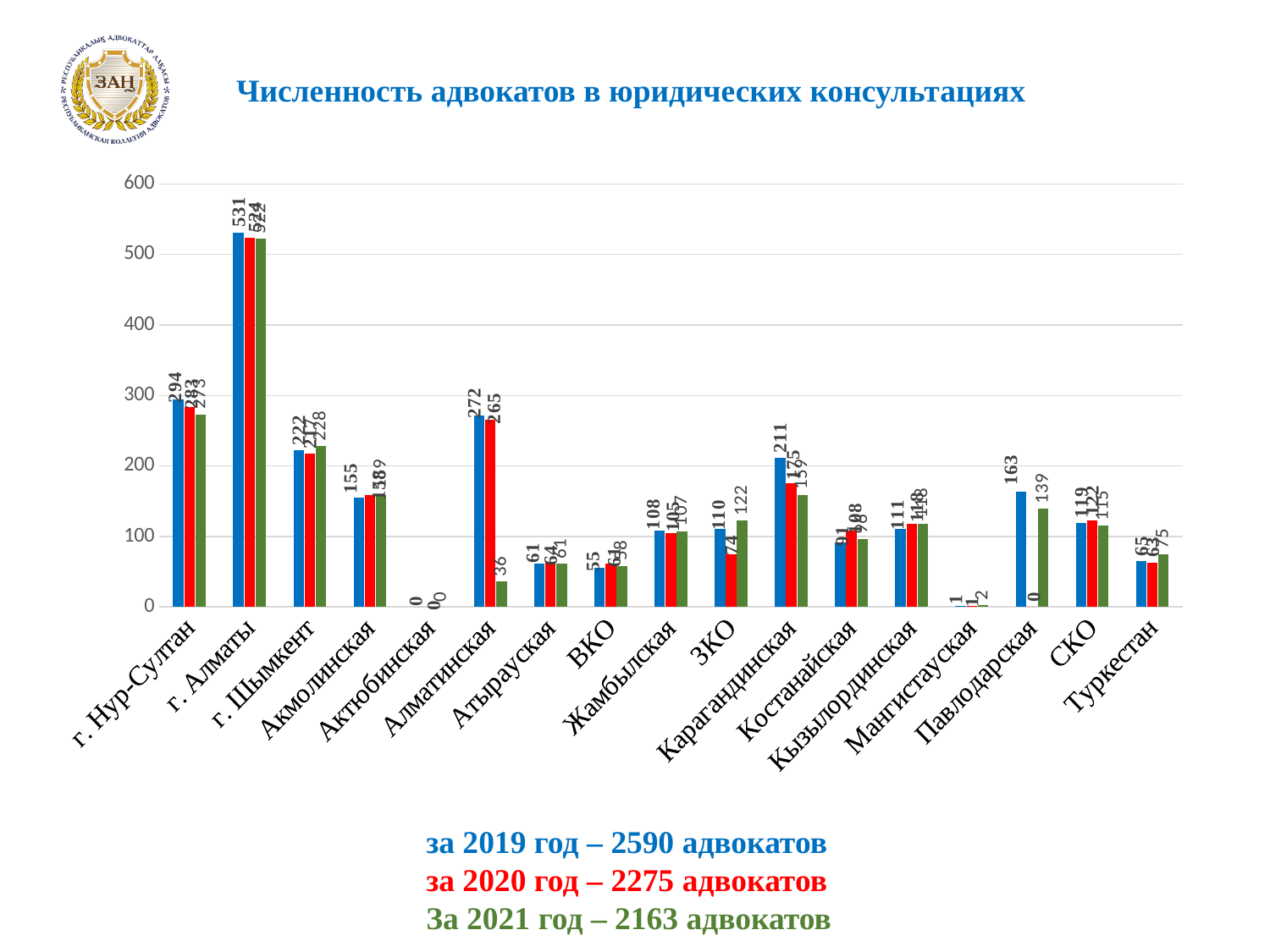
What is the title of the chart? Численность адвокатов в юридических консультациях Is the value of the blue (2019) bar for Карагандинская greater or less than 200? greater How many regions (categories) are shown along the x axis of the chart? 17 Which region has the tallest bars in the chart? г. Алматы What is the difference between the blue (2019) bar and the green (2021) bar for Павлодарская? 24 What is the value of the green (2021) bar for Алматинская? 36 What is the value of the blue (2019) bar for Павлодарская? 163 For ЗКО, which is larger: the red (2020) bar or the green (2021) bar? the green (2021) bar What is the value of the green (2021) bar for ЗКО? 122 What is the value of the blue (2019) bar for Алматинская? 272 What kind of chart is shown on the slide? bar chart What is the value of the blue (2019) bar for г. Нур-Султан? 294